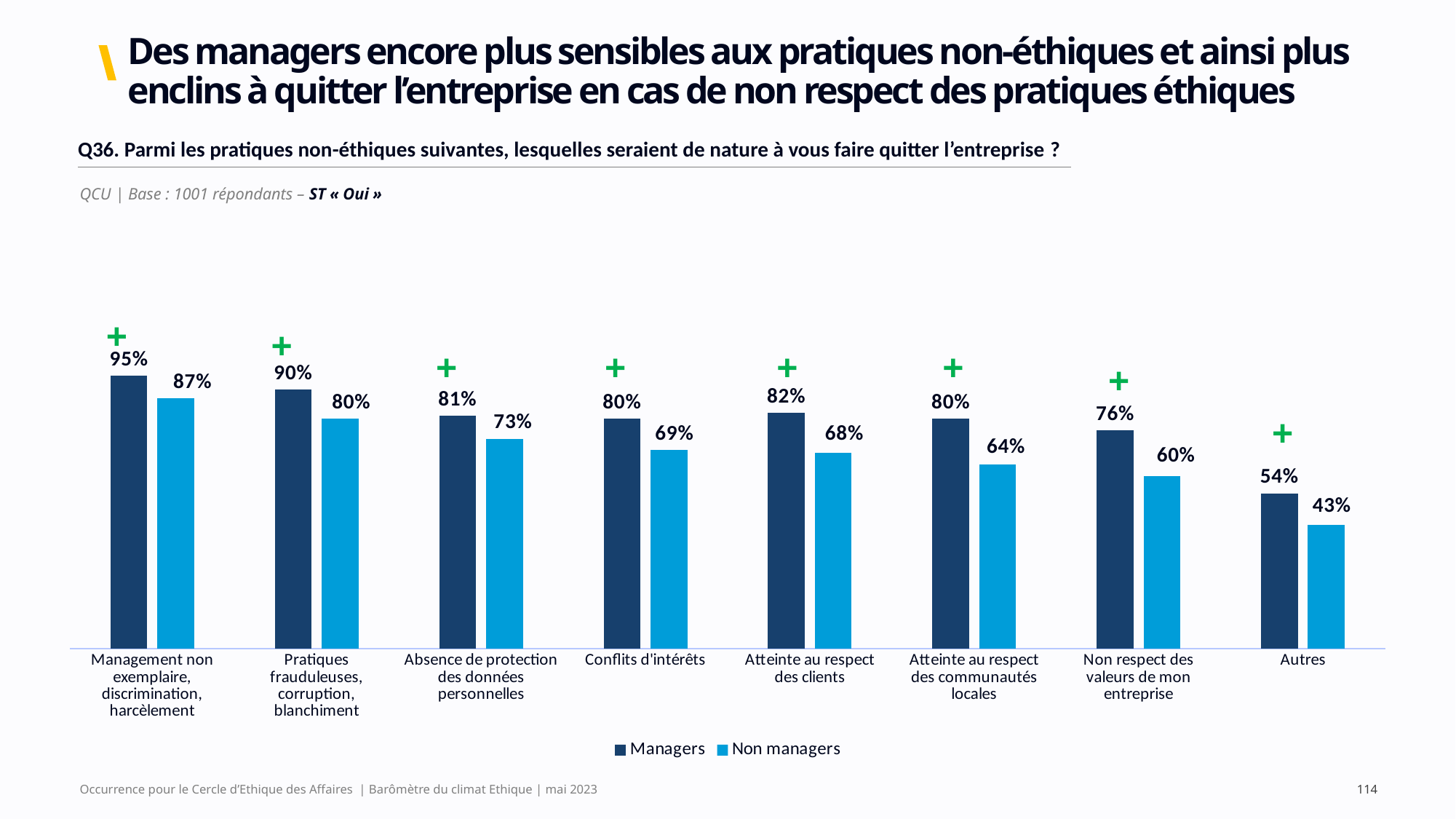
Which category has the highest value for Managers? Management non exemplaire, discrimination, harcèlement How many categories are shown on the x axis? 8 Which is larger: the Non managers value for "Pratiques frauduleuses, corruption, blanchiment" or the Non managers value for "Absence de protection des données personnelles"? Pratiques frauduleuses, corruption, blanchiment What is the value for Non managers for "Atteinte au respect des communautés locales"? 64% Which series is shown in dark blue according to the legend? Managers What kind of chart is shown on the slide? Bar chart How many series does the legend list? 2 What is the value for Managers for "Conflits d'intérêts"? 80% What is the difference between the Managers and Non managers values for "Atteinte au respect des clients"? 14 percentage points Which category has the lowest value for Non managers? Autres What is the value for Non managers for "Autres"? 43% What is the difference between the Managers and Non managers values for "Non respect des valeurs de mon entreprise"? 16 percentage points